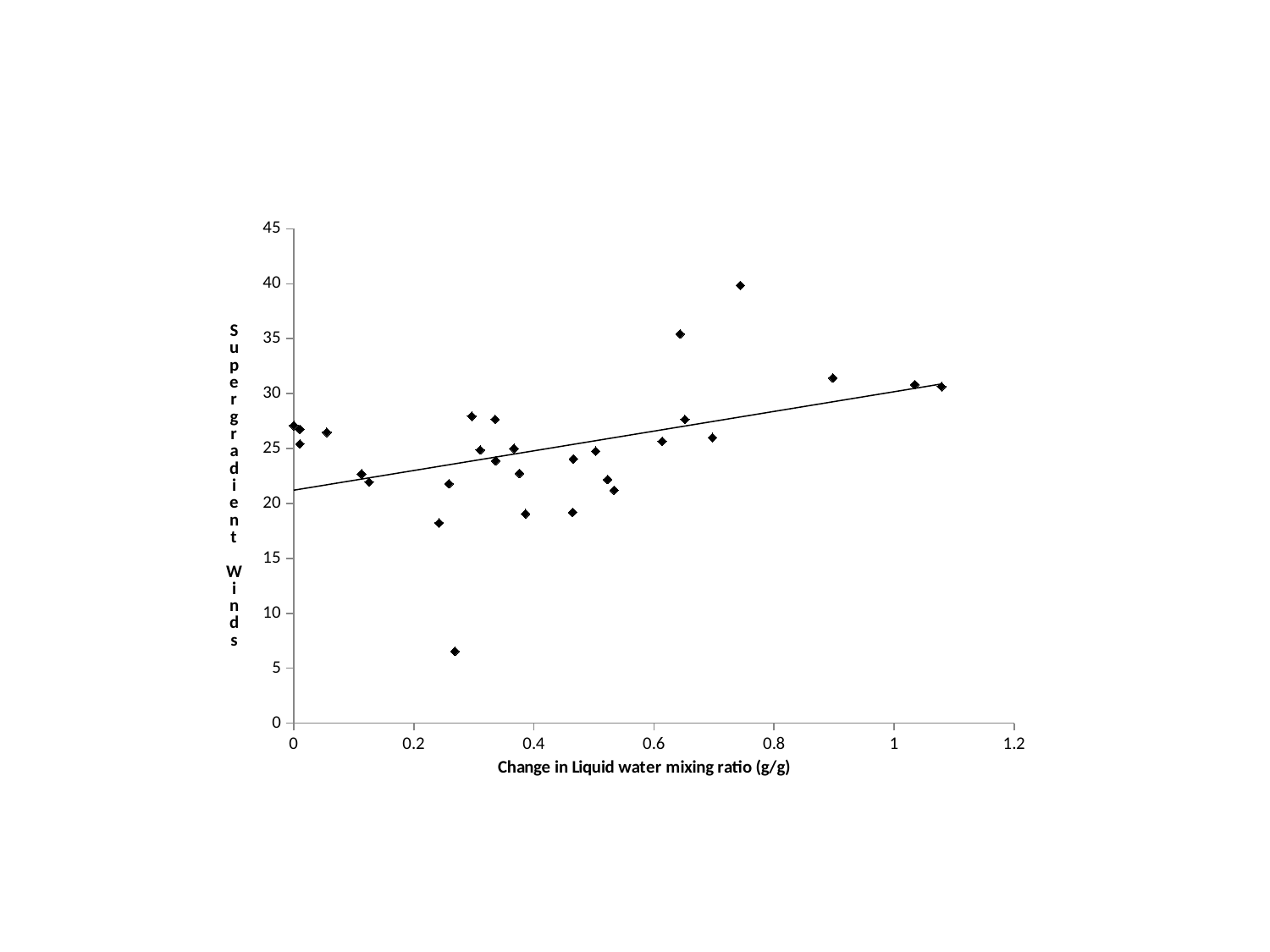
Is the lowest plotted Supergradient Winds value greater or less than 10? less What is the label of the x axis? Change in Liquid water mixing ratio (g/g) What kind of chart is shown on the slide? scatter plot Does the fitted trend line rise or fall as the change in liquid water mixing ratio increases? rises Is the value of the trend line at a change in liquid water mixing ratio of 1 greater or less than 25? greater What is the label of the y axis? Supergradient Winds Is the point with the largest change in liquid water mixing ratio (near 1.08) greater or less than 25 on the Supergradient Winds axis? greater